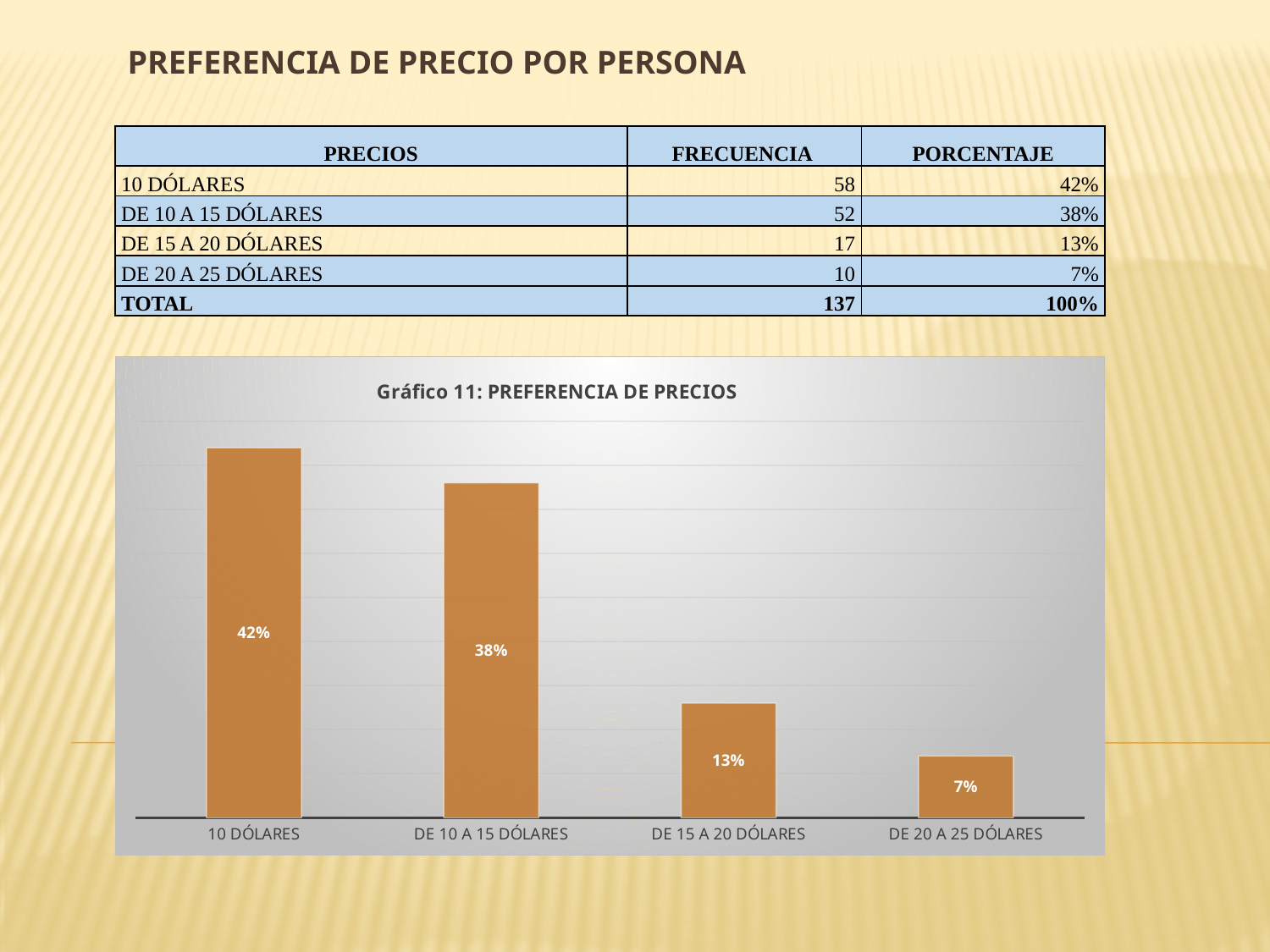
Which is larger, the value for DE 10 A 15 DÓLARES or the value for DE 15 A 20 DÓLARES? DE 10 A 15 DÓLARES What is the difference between the values for 10 DÓLARES and DE 10 A 15 DÓLARES? 4% What is the value for DE 20 A 25 DÓLARES in the chart? 7% What kind of chart is shown on the slide? Bar chart Which category has the highest value in the chart? 10 DÓLARES What is the difference between the values for DE 15 A 20 DÓLARES and DE 20 A 25 DÓLARES? 6% What is the title of the chart? Gráfico 11: PREFERENCIA DE PRECIOS What is the value for DE 15 A 20 DÓLARES in the chart? 13% How many categories are shown in the chart? 4 What is the value for DE 10 A 15 DÓLARES in the chart? 38% What is the value for 10 DÓLARES in the chart? 42% Which category has the lowest value in the chart? DE 20 A 25 DÓLARES